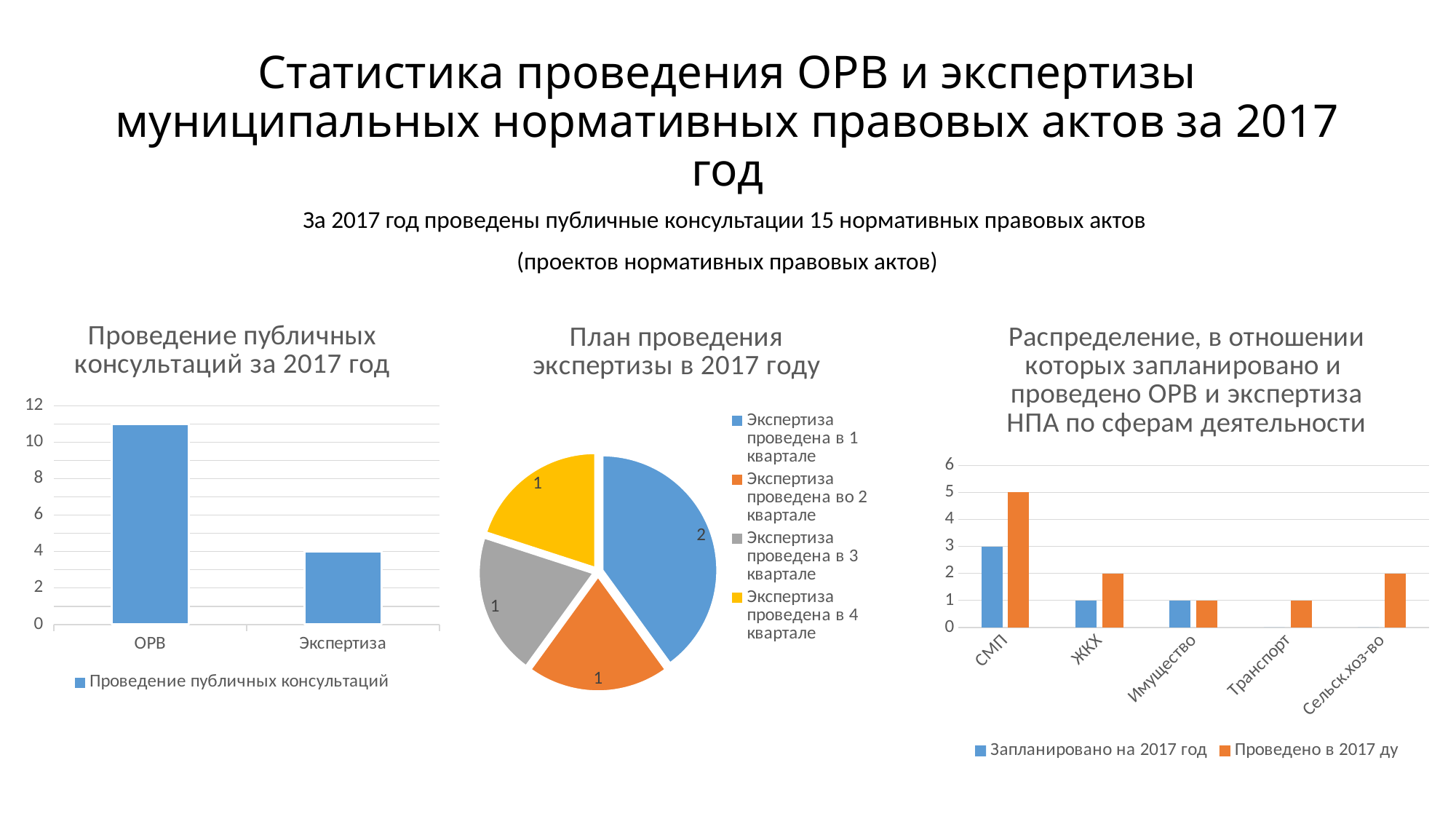
How many slices does the pie chart 'План проведения экспертизы в 2017 году' have? 4 On the chart 'Распределение, в отношении которых запланировано и проведено ОРВ и экспертиза НПА по сферам деятельности', what is the difference between 'Проведено в 2017 ду' and 'Запланировано на 2017 год' for ЖКХ? 1 On the chart 'Проведение публичных консультаций за 2017 год', is the value for ОРВ greater or less than 10? greater On the chart 'Проведение публичных консультаций за 2017 год', is the value for Экспертиза greater or less than 6? less What kind of chart is 'План проведения экспертизы в 2017 году'? pie chart On the pie chart 'План проведения экспертизы в 2017 году', what is the value for 'Экспертиза проведена в 1 квартале'? 2 On the chart 'Проведение публичных консультаций за 2017 год', which category has the higher value, ОРВ or Экспертиза? ОРВ On the chart 'Распределение, в отношении которых запланировано и проведено ОРВ и экспертиза НПА по сферам деятельности', what is the value of 'Запланировано на 2017 год' for СМП? 3 On the chart 'Распределение, в отношении которых запланировано и проведено ОРВ и экспертиза НПА по сферам деятельности', what is the value of 'Проведено в 2017 ду' for СМП? 5 On the pie chart 'План проведения экспертизы в 2017 году', what share of the total does 'Экспертиза проведена в 1 квартале' represent? 40% On the pie chart 'План проведения экспертизы в 2017 году', which slice is the largest? Экспертиза проведена в 1 квартале On the chart 'Распределение, в отношении которых запланировано и проведено ОРВ и экспертиза НПА по сферам деятельности', how many series does the legend list? 2